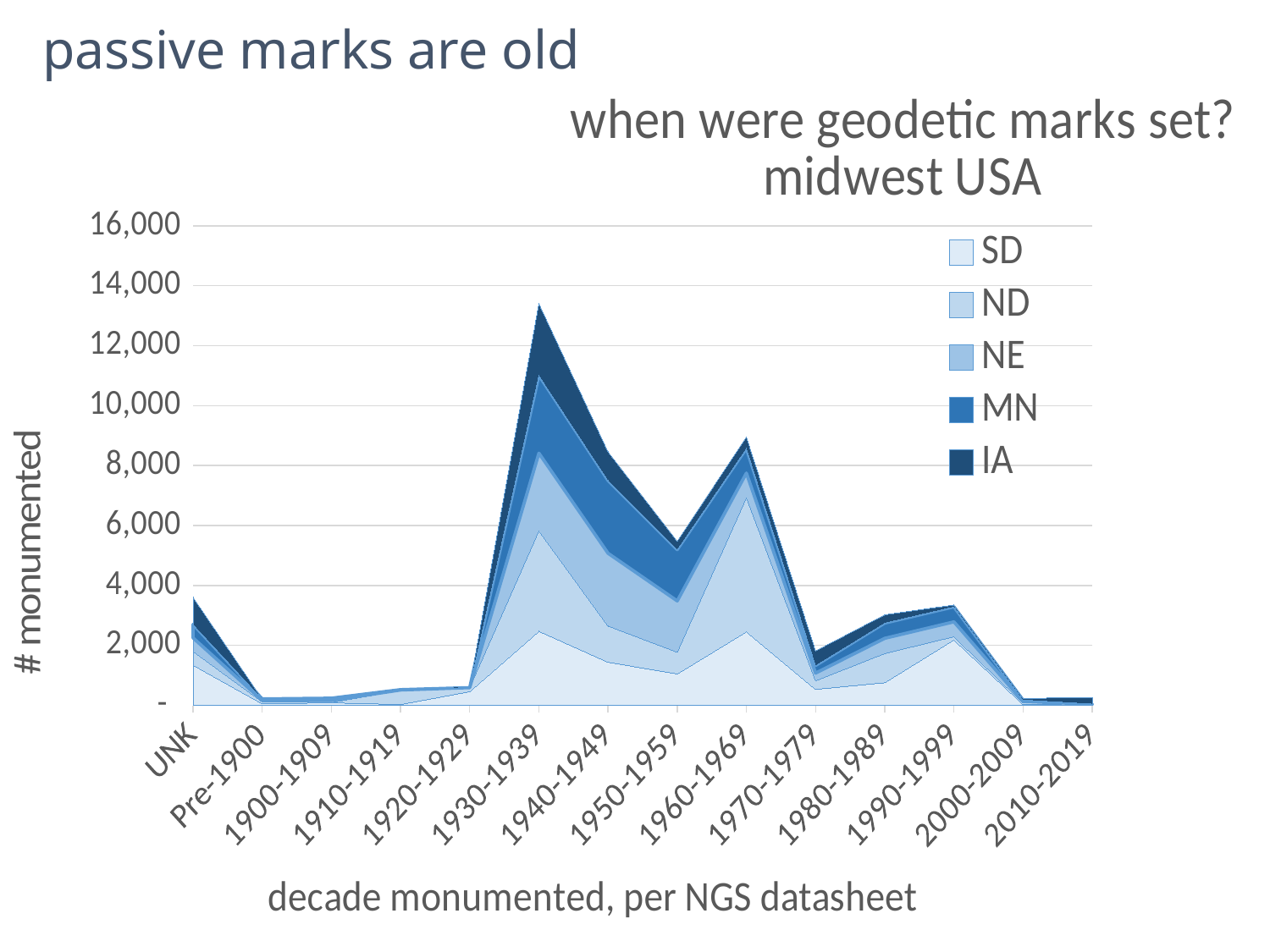
Do the total values rise or fall from 1960-1969 to 1970-1979? fall What is the label of the x axis? decade monumented, per NGS datasheet How many series does the legend list? 5 Is the total value for 1990-1999 greater or less than 4,000? less What kind of chart is shown on the slide? stacked area chart What is the title of the chart? when were geodetic marks set? midwest USA Is the total value for 1930-1939 greater or less than 12,000? greater Is the total value for 1960-1969 greater or less than 8,000? greater How many decade categories are shown on the x axis? 14 Which decade category has the highest total number of marks monumented? 1930-1939 Which has a larger total, 1940-1949 or 1950-1959? 1940-1949